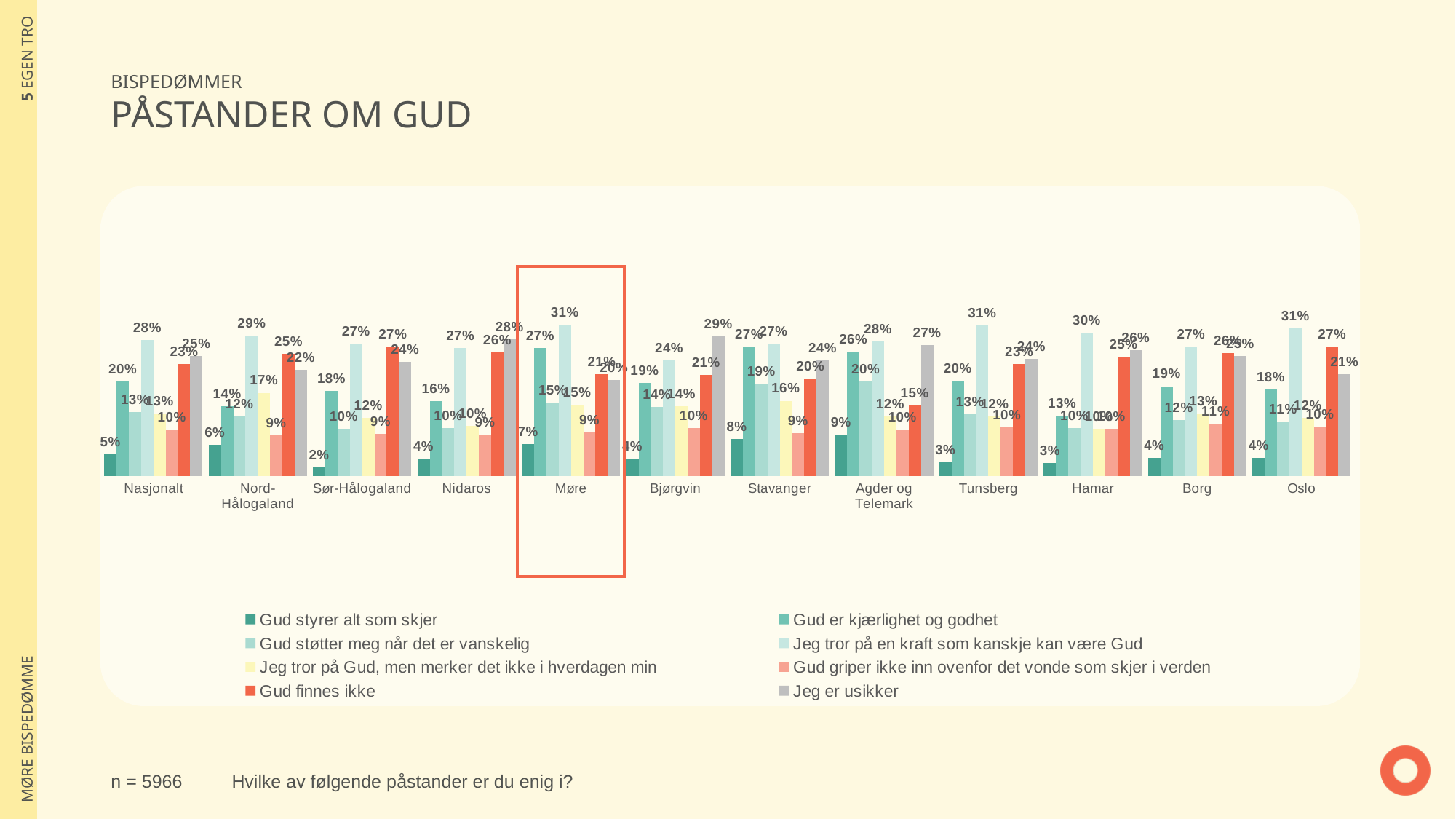
What is the value for Hamar in the "Jeg er usikker" series? 26% How many categories are shown on the x axis? 12 What is the value for Nasjonalt in the "Jeg tror på en kraft som kanskje kan være Gud" series? 28% What is the difference between Møre and Nasjonalt in the "Jeg tror på en kraft som kanskje kan være Gud" series? 3 percentage points How many series does the legend list? 8 Which category has the lowest value in the "Gud styrer alt som skjer" series? Sør-Hålogaland Which category is highlighted with a red box on the chart? Møre What is the value for Møre in the "Gud finnes ikke" series? 21% What kind of chart is shown on the slide? Bar chart Which is larger in the "Gud er kjærlighet og godhet" series: Stavanger or Hamar? Stavanger What is the value for Agder og Telemark in the "Gud styrer alt som skjer" series? 9% Which category has the highest value in the "Gud styrer alt som skjer" series? Agder og Telemark